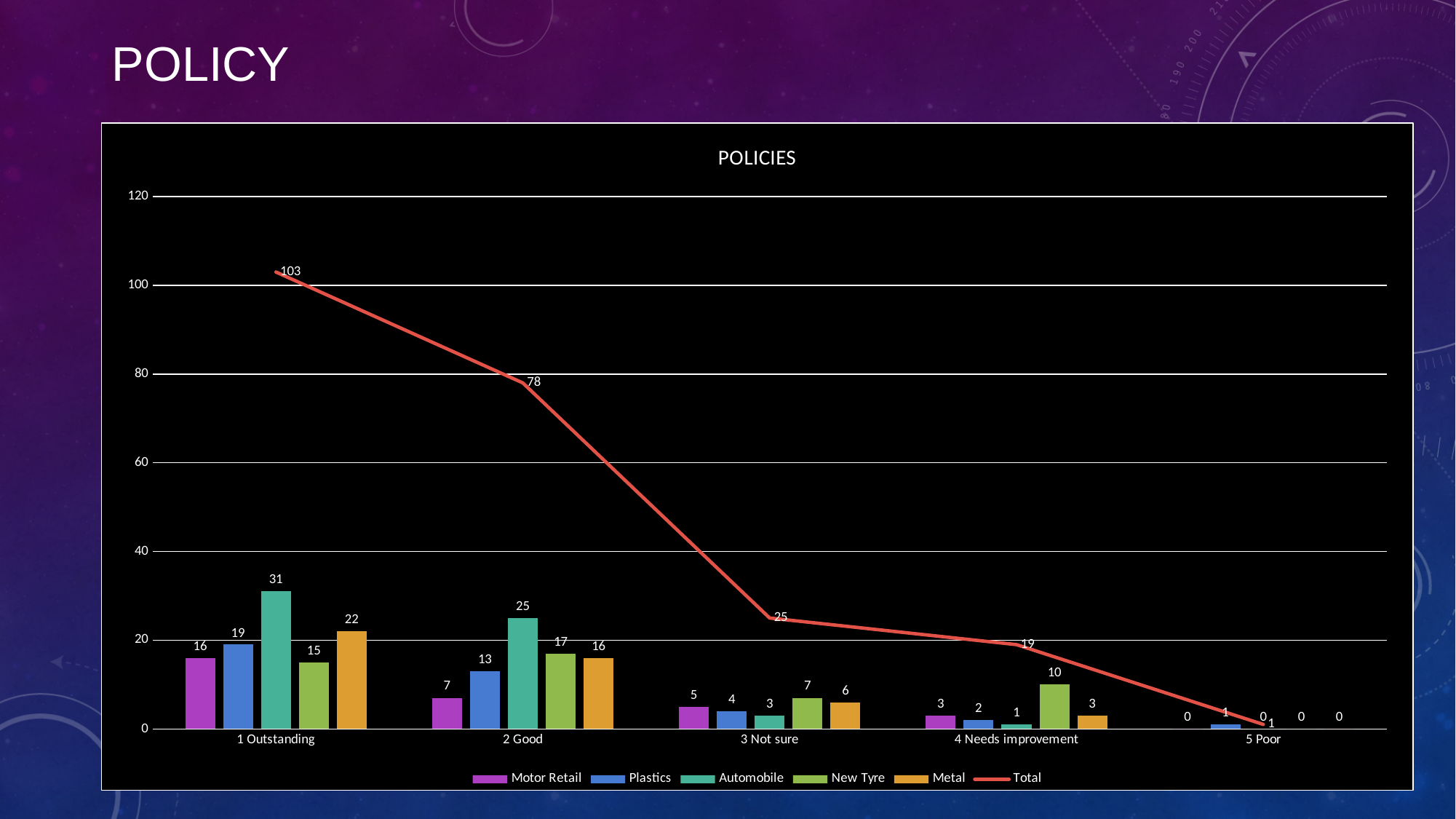
What is the Automobile value for 2 Good? 25 How many categories are shown on the x axis? 5 What is the New Tyre value for 4 Needs improvement? 10 How many series does the legend list? 6 Does the Total line rise or fall from 1 Outstanding to 5 Poor? Fall What is the Total value for 1 Outstanding? 103 Which category has the highest Total value? 1 Outstanding What is the difference between the Total for 1 Outstanding and the Total for 2 Good? 25 Which series has the lowest value for 1 Outstanding? New Tyre What is the Metal value for 3 Not sure? 6 Which is larger for 2 Good: Plastics or Metal? Metal What is the title of the chart? POLICIES